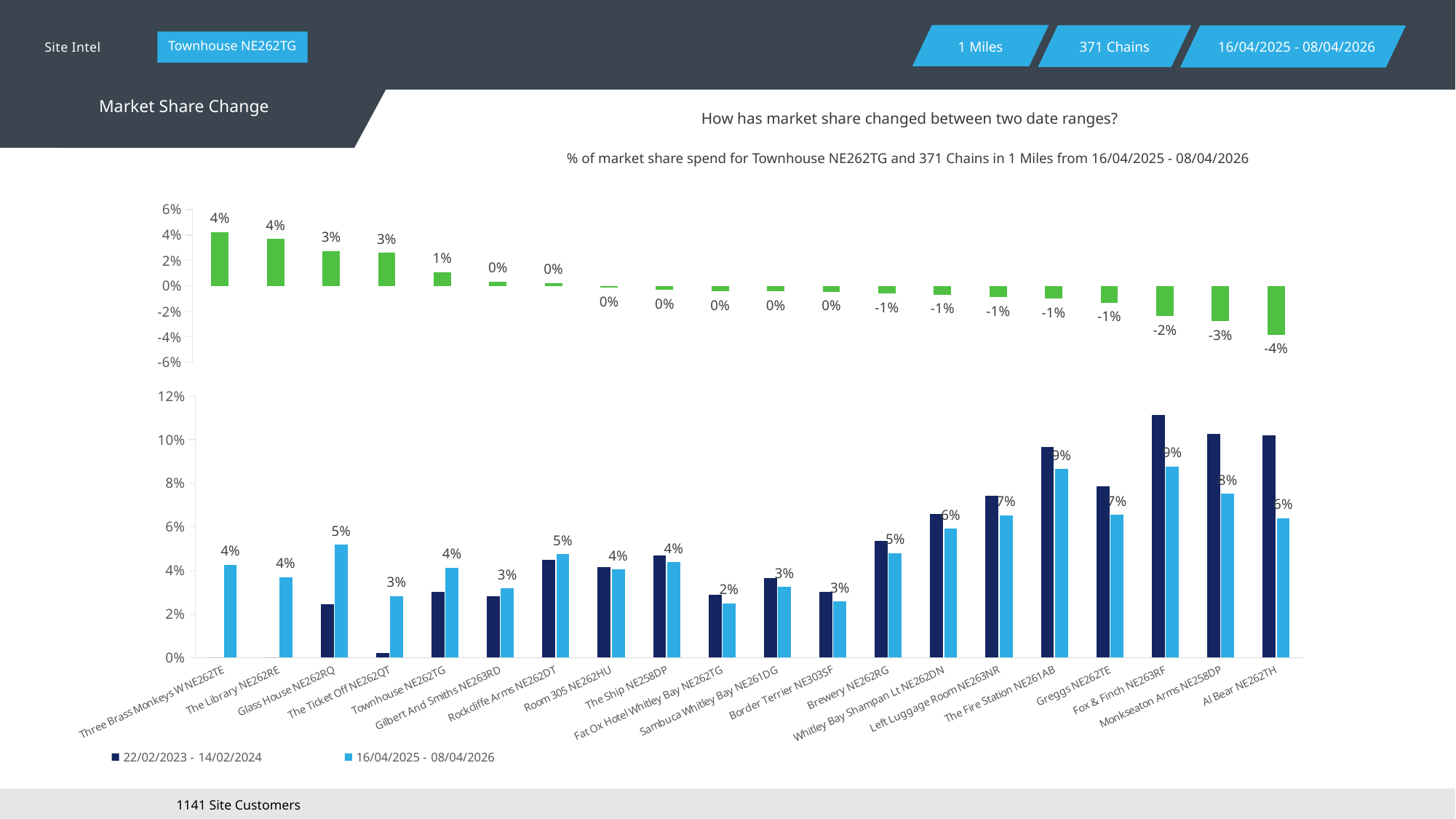
In the top chart, which category has the lowest market share change? Al Bear NE262TH In the top chart, what is the market share change for Fox & Finch NE263RF? -2% How many series does the legend of the bottom chart list? 2 In the top chart, do the values rise or fall from left to right along the x axis? fall How many categories are shown in the top chart? 20 In the bottom chart, is the 22/02/2023 - 14/02/2024 value for Fox & Finch NE263RF greater or less than 10%? greater What kind of chart is the bottom chart? bar chart In the top chart, what is the market share change for Al Bear NE262TH? -4% In the bottom chart, for Glass House NE262RQ, which series has the larger value? 16/04/2025 - 08/04/2026 In the bottom chart, what is the 16/04/2025 - 08/04/2026 value for The Fire Station NE261AB? 9% In the top chart, what is the market share change for Three Brass Monkeys W NE262TE? 4% In the bottom chart, what is the difference between the 16/04/2025 - 08/04/2026 values for The Fire Station NE261AB and Three Brass Monkeys W NE262TE? 5%